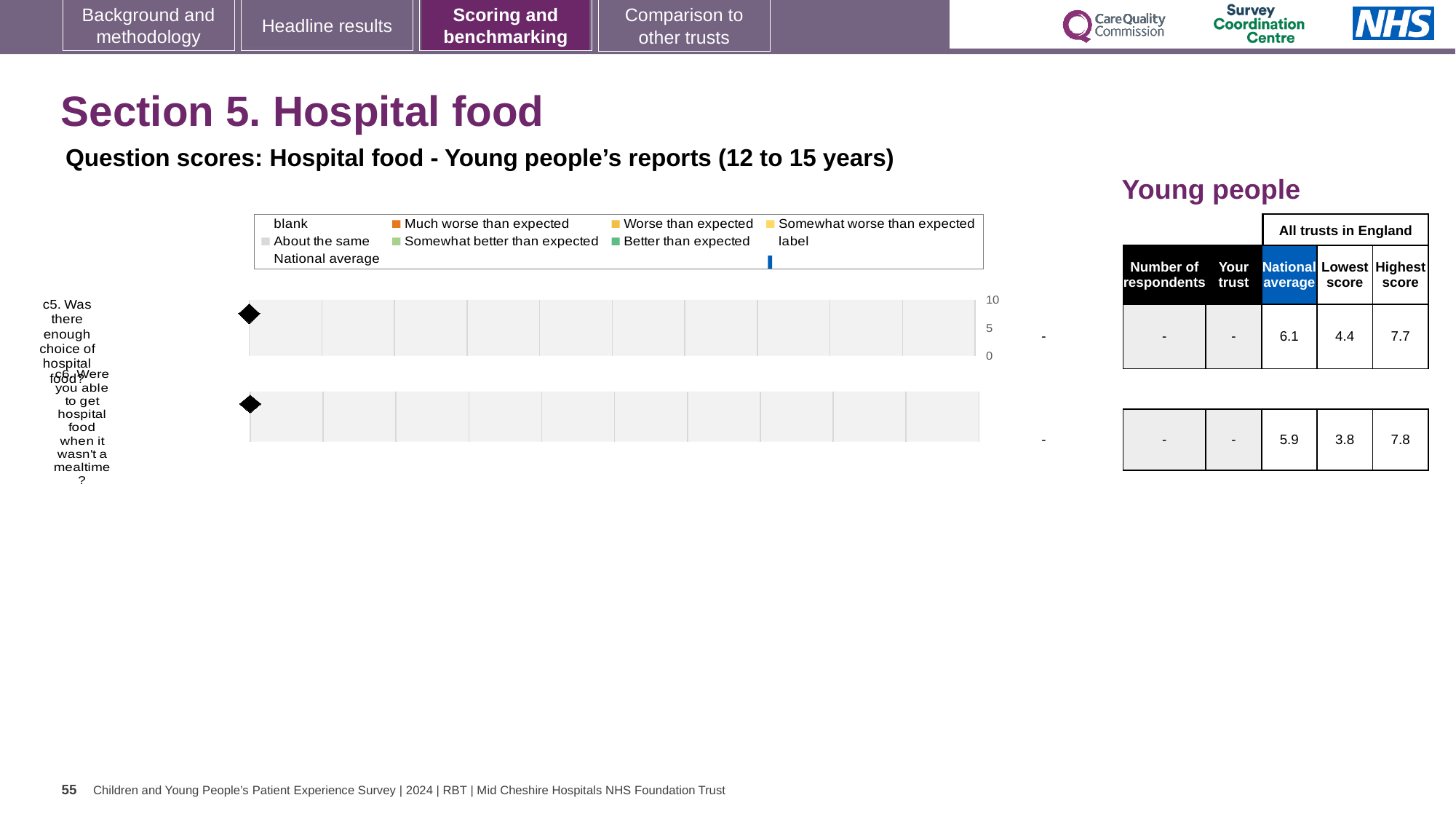
What is the lowest score across all trusts in England for question c5? 4.4 What is the difference between the highest score and the lowest score for question c5? 3.3 What is the highest score across all trusts in England for question c6? 7.8 What is the national average score for question c6 (Were you able to get hospital food when it wasn't a mealtime?)? 5.9 What kind of chart is shown on the slide? bar chart What is the national average score for question c5 (Was there enough choice of hospital food?)? 6.1 How many survey questions (categories) are plotted on the chart? 2 What is the maximum value shown on the chart's score axis? 10 What value is shown for 'Your trust' for question c5? - Which question has the higher national average score, c5 or c6? c5 What is the difference between the highest score and the lowest score for question c6? 4.0 Which question has the lower lowest score across all trusts in England, c5 or c6? c6